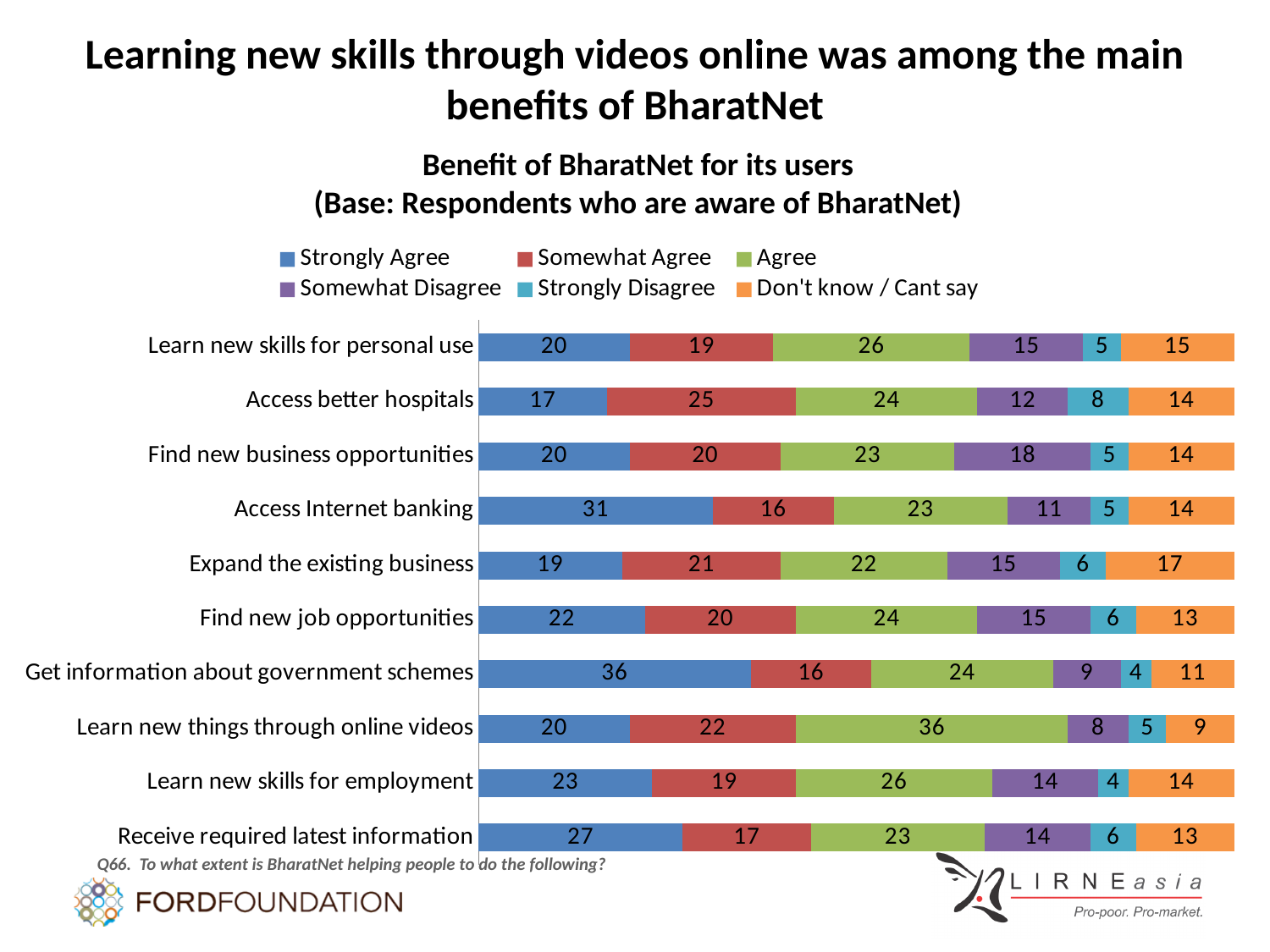
Which category has the lowest Strongly Agree value? Access better hospitals What is the Agree value for Learn new things through online videos? 36 What kind of chart is shown on the slide? Stacked bar chart Which is larger: the Agree value for Learn new things through online videos or the Agree value for Learn new skills for employment? Learn new things through online videos How many series does the legend list? 6 What is the Don't know / Cant say value for Expand the existing business? 17 What is the Strongly Agree value for Access Internet banking? 31 What is the Somewhat Agree value for Access better hospitals? 25 What is the total of the stacked bar for Learn new things through online videos? 100 How many categories are shown on the chart? 10 Which category has the highest Strongly Agree value? Get information about government schemes What is the difference between the Strongly Agree values for Get information about government schemes and Access Internet banking? 5